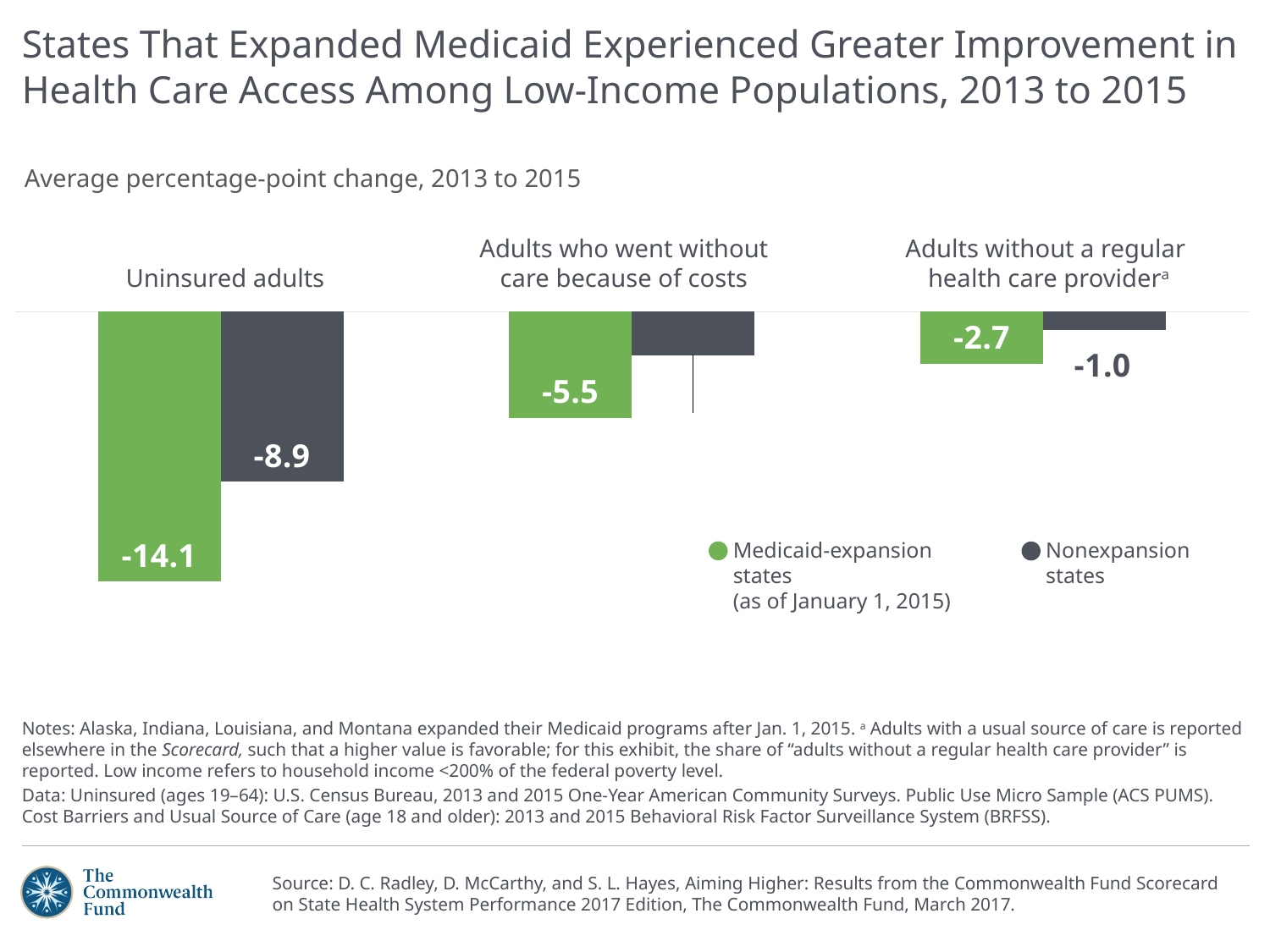
What kind of chart is shown on the slide? Bar chart Among the Medicaid-expansion state bars, which category has the lowest value? Uninsured adults How many series does the legend list? 2 For adults without a regular health care provider, what is the difference between the Medicaid-expansion and nonexpansion values? 1.7 For uninsured adults, how many percentage points larger is the decline in Medicaid-expansion states than in nonexpansion states? 5.2 What is the value for Medicaid-expansion states for adults who went without care because of costs? -5.5 What is the value for nonexpansion states for adults without a regular health care provider? -1.0 For uninsured adults, which group shows the larger decline: Medicaid-expansion states or nonexpansion states? Medicaid-expansion states What is the average percentage-point change for uninsured adults in nonexpansion states? -8.9 What is the average percentage-point change for uninsured adults in Medicaid-expansion states? -14.1 How many categories are shown on the chart? 3 What is the value for Medicaid-expansion states for adults without a regular health care provider? -2.7